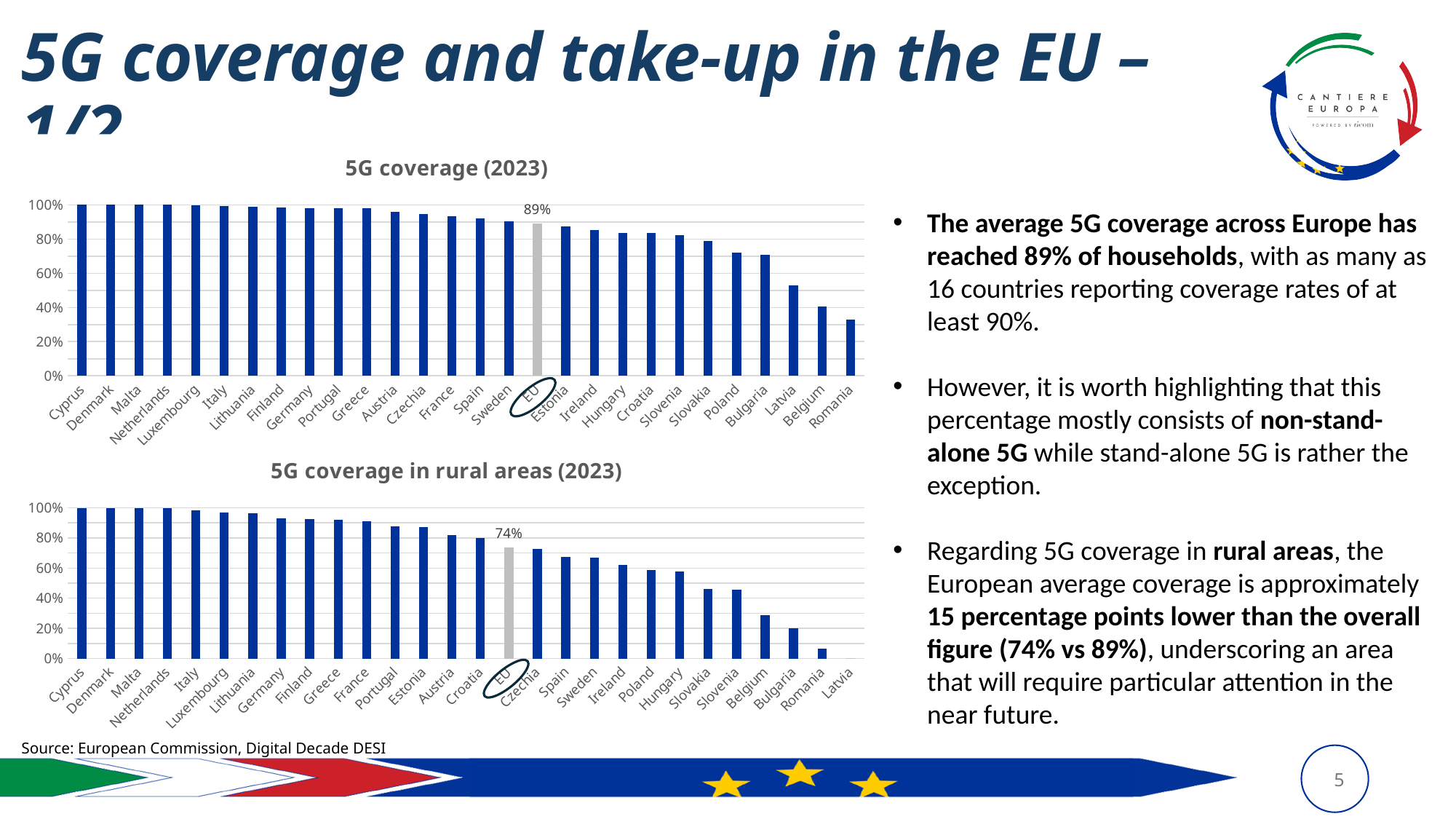
In the '5G coverage in rural areas (2023)' chart, which country has the lowest value? Latvia What is the difference between the EU value in the '5G coverage (2023)' chart and the EU value in the '5G coverage in rural areas (2023)' chart? 15 percentage points What type of chart is the '5G coverage (2023)' chart? Bar chart In the '5G coverage (2023)' chart, what value is labelled for the EU bar? 89% In the '5G coverage in rural areas (2023)' chart, which has the higher value, Slovakia or Belgium? Slovakia In the '5G coverage in rural areas (2023)' chart, what value is labelled for the EU bar? 74% In the '5G coverage (2023)' chart, which country has the lowest 5G coverage? Romania In the '5G coverage (2023)' chart, which has the higher value, Latvia or Romania? Latvia In the '5G coverage (2023)' chart, is the value for Romania greater or less than 40%? less In the '5G coverage in rural areas (2023)' chart, is the value for Slovakia greater or less than 40%? greater In the '5G coverage in rural areas (2023)' chart, do the values rise or fall from left to right along the x axis? Fall In the '5G coverage in rural areas (2023)' chart, is the value for Latvia greater or less than 20%? less